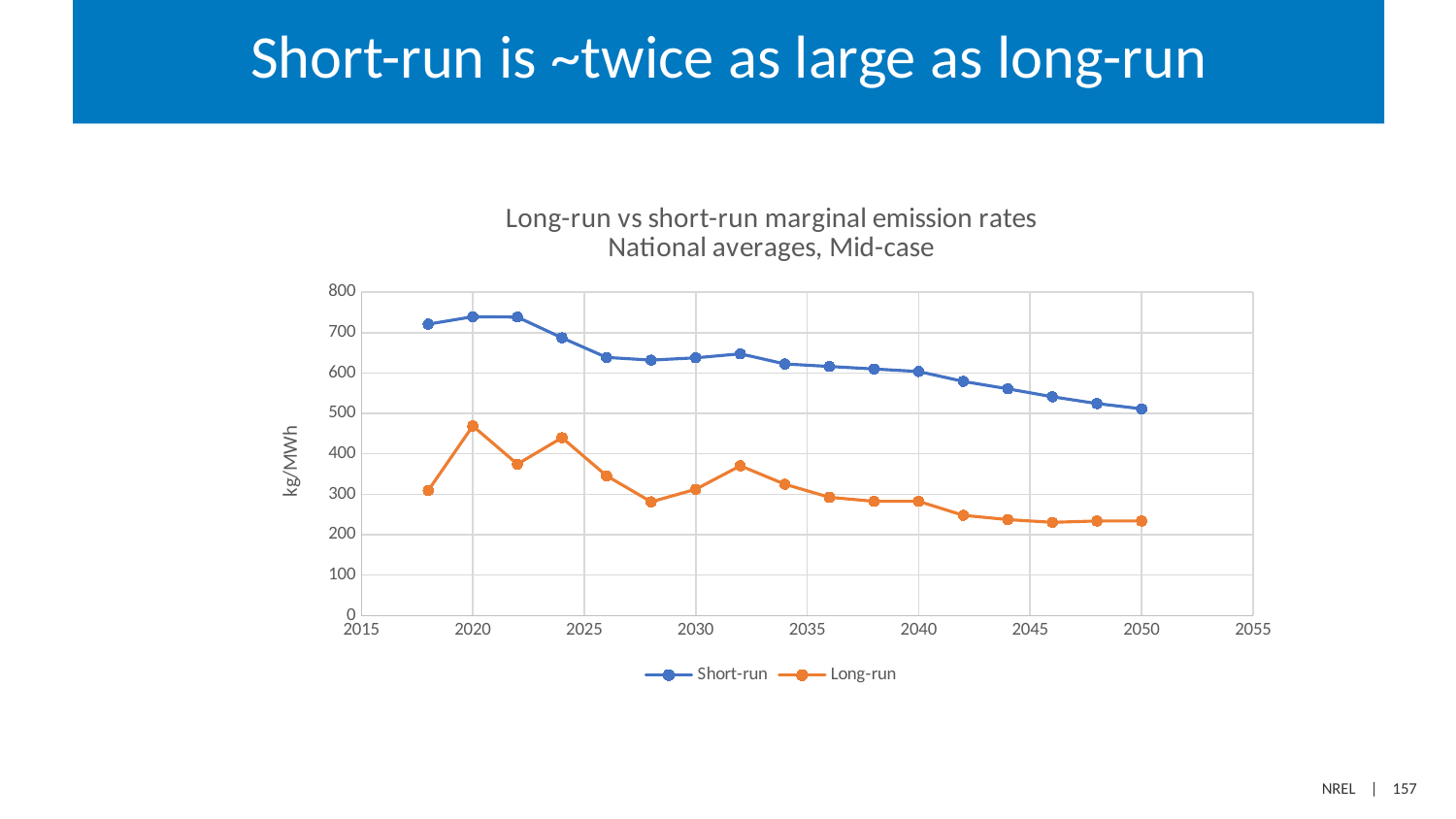
How many series does the legend list? 2 Do the Short-run values rise or fall from 2018 to 2050? fall In which year does the Long-run series reach its highest value? 2020 Is the Long-run value for 2050 greater or less than 300? less Is the Short-run value for 2050 greater or less than 400? greater Which series has the larger value in 2030, Short-run or Long-run? Short-run Is the Long-run value for 2020 greater or less than 400? greater What kind of chart is shown on the slide? line chart How many data points are plotted for the Short-run series? 17 In which year does the Short-run series reach its lowest value? 2050 What is the label on the y axis of the chart? kg/MWh